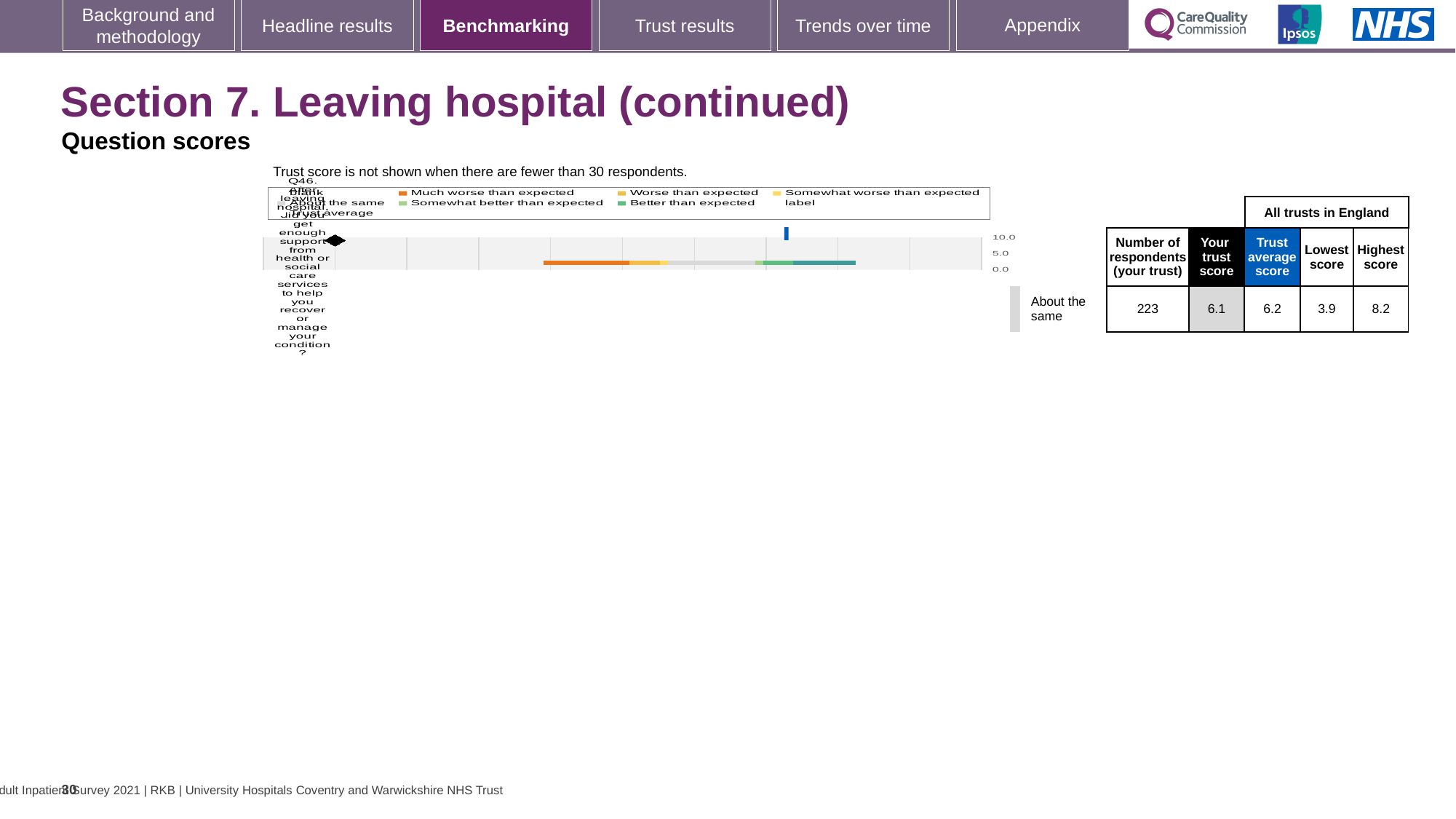
What colour is the legend entry 'Much worse than expected'? orange What kind of chart is shown on the slide for Q46? bar chart Is your trust score for Q46 greater or less than 5.0? greater Which benchmark category is your trust placed in for Q46? About the same What is the difference between the highest score and the lowest score for Q46? 4.3 What is the highest value shown on the chart's axis? 10.0 What is the highest score among all trusts in England for Q46? 8.2 Which is larger for Q46, your trust score or the trust average score? Trust average score What is the lowest score among all trusts in England for Q46? 3.9 What is your trust score for Q46? 6.1 What is the number of respondents for your trust shown next to the chart? 223 What is the trust average score for Q46? 6.2